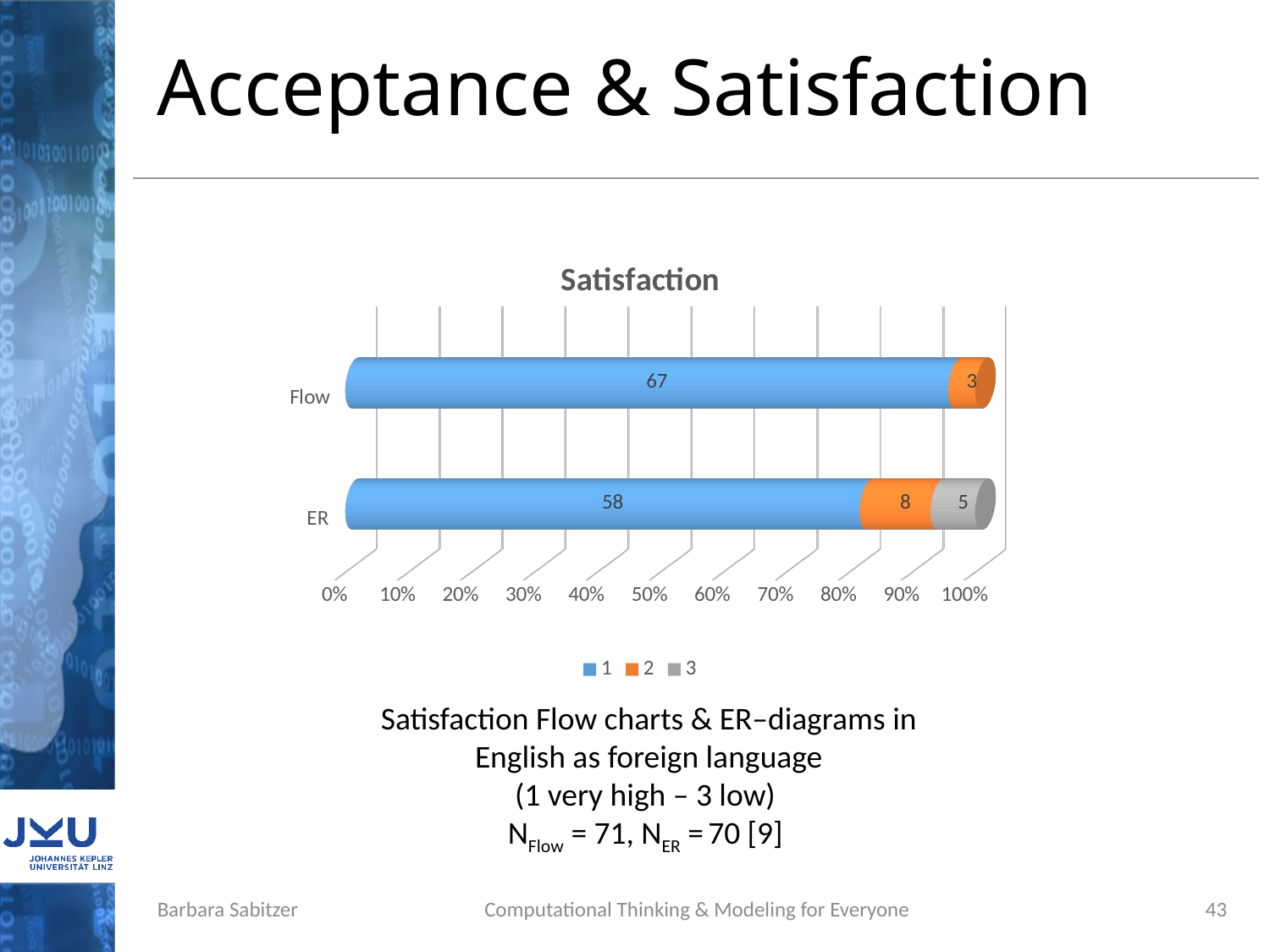
How many series does the legend list? 3 What is the value of series 1 for ER? 58 What is the value of series 1 for Flow? 67 What is the value of series 3 for ER? 5 Which category has the higher value for series 1, Flow or ER? Flow How many categories are shown on the vertical axis? 2 What is the difference between the series 2 and series 3 values for ER? 3 What is the difference between the series 1 values for Flow and ER? 9 What type of chart is shown on the slide? Stacked bar chart What is the title of the chart? Satisfaction What is the value of series 2 for Flow? 3 Is the share of the Flow bar taken by series 1 greater or less than 90%? greater